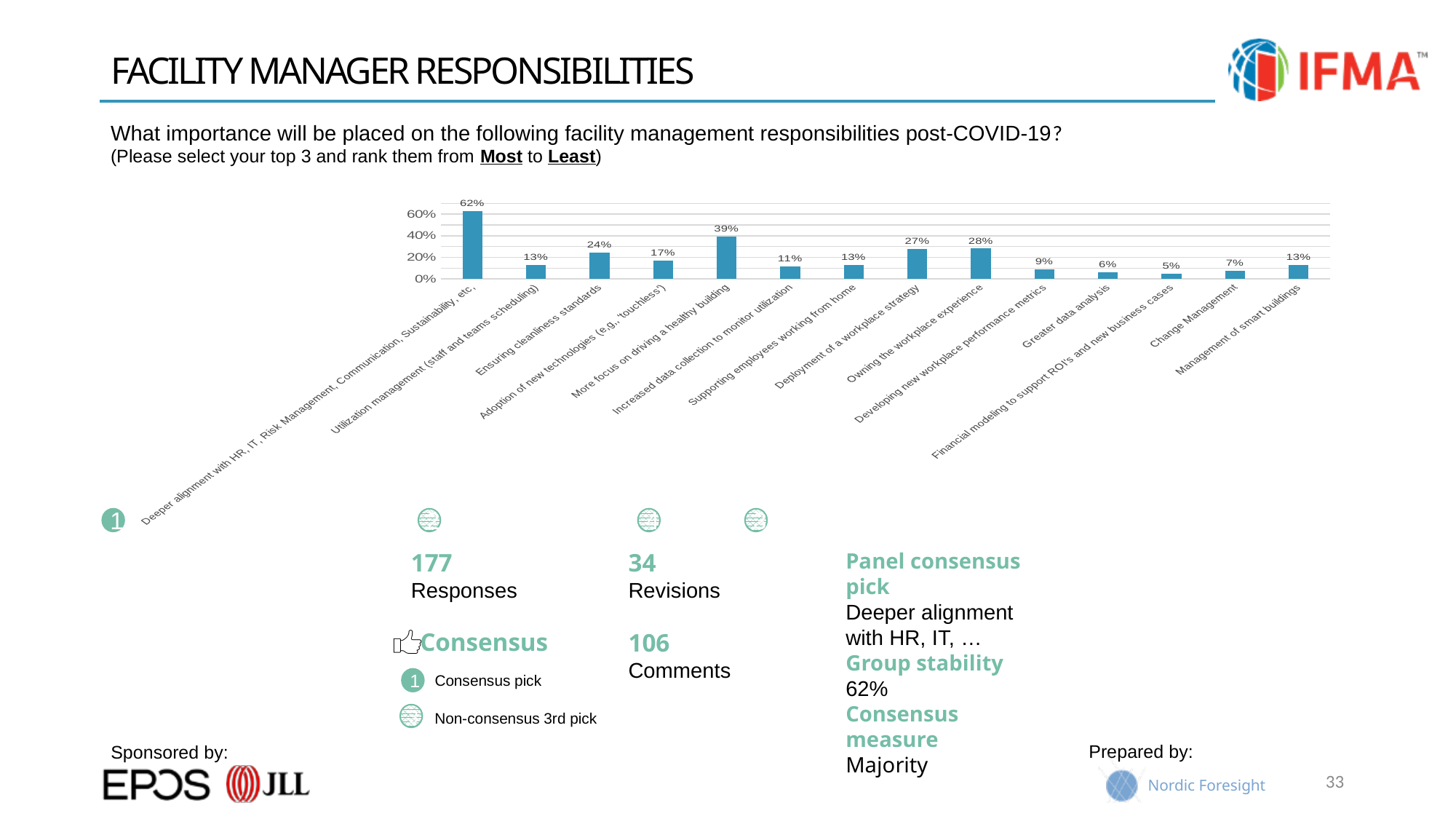
Which is larger: the value for 'Adoption of new technologies (e.g., 'touchless')' or the value for 'Greater data analysis'? Adoption of new technologies (e.g., 'touchless') What value is shown for 'Change Management'? 7% What is the difference between the values for 'More focus on driving a healthy building' and 'Deployment of a workplace strategy'? 12% What value is shown for 'Ensuring cleanliness standards'? 24% What value is shown for 'More focus on driving a healthy building'? 39% Is the value for 'Deeper alignment with HR, IT, Risk Management, Communication, Sustainability, etc.' greater or less than 40%? greater What value is shown for 'Owning the workplace experience'? 28% Which category has the lowest value in the chart? Financial modeling to support ROI's and new business cases How many categories are shown in the chart? 14 Which category has the highest value in the chart? Deeper alignment with HR, IT, Risk Management, Communication, Sustainability, etc. What kind of chart is shown on the slide? Bar chart What value is shown for 'Increased data collection to monitor utilization'? 11%